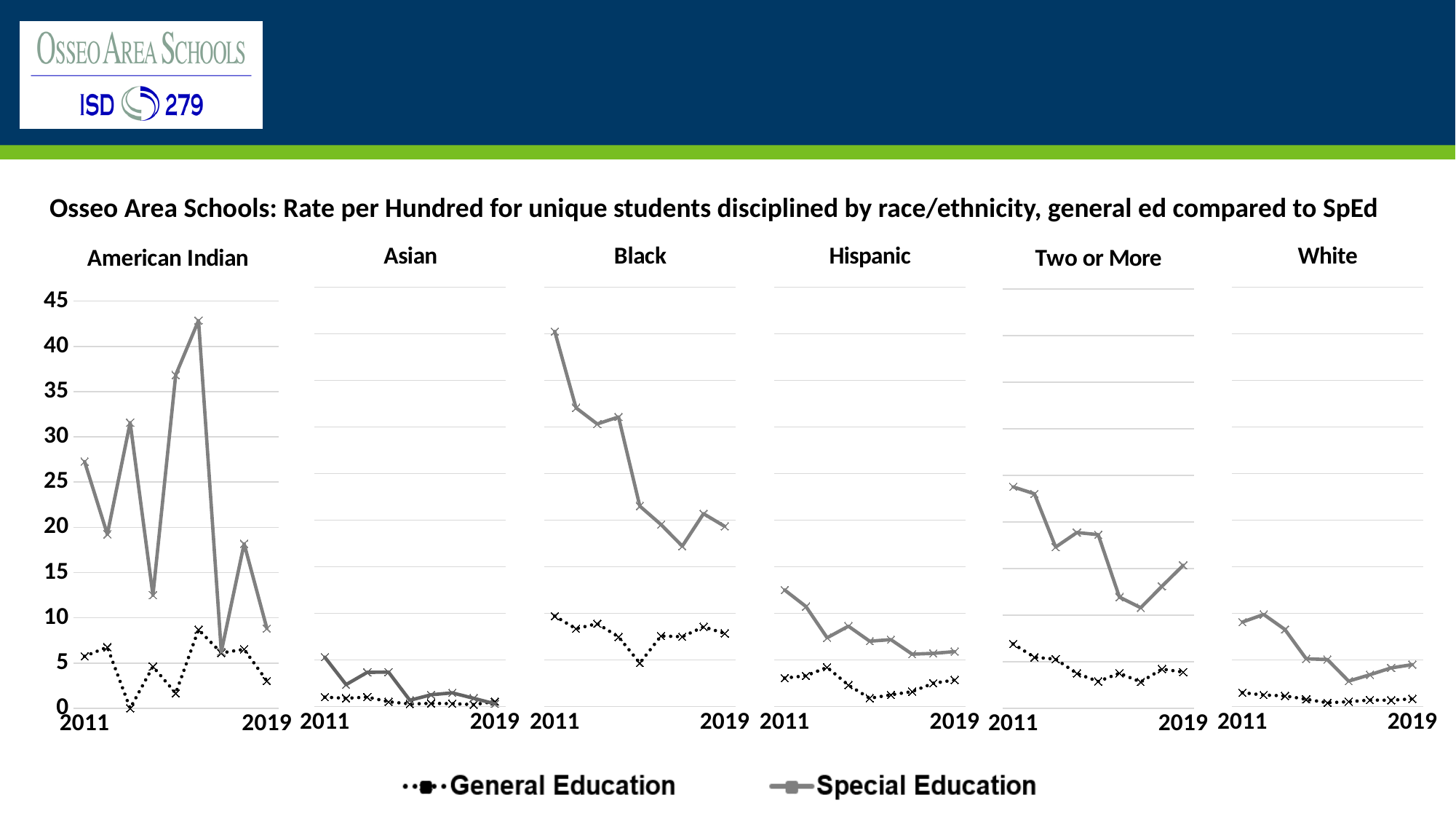
In the Black panel, does the Special Education line rise or fall from 2011 to 2019? fall In the Two or More panel, does the Special Education line rise or fall overall from 2011 to 2019? fall Which panel shows the lowest Special Education values across all years? Asian In the Asian panel, is the Special Education value for 2011 greater or less than 10? less What kind of chart is used in each of the six panels on the slide? line chart In the Black panel, which series is higher in 2011, General Education or Special Education? Special Education What are the two series named in the legend? General Education and Special Education In the Hispanic panel, is the Special Education value for 2011 greater or less than 10? greater How many series does the legend list? 2 In the Black panel, is the Special Education value for 2011 greater or less than 35? greater How many race/ethnicity panels are shown on the slide? 6